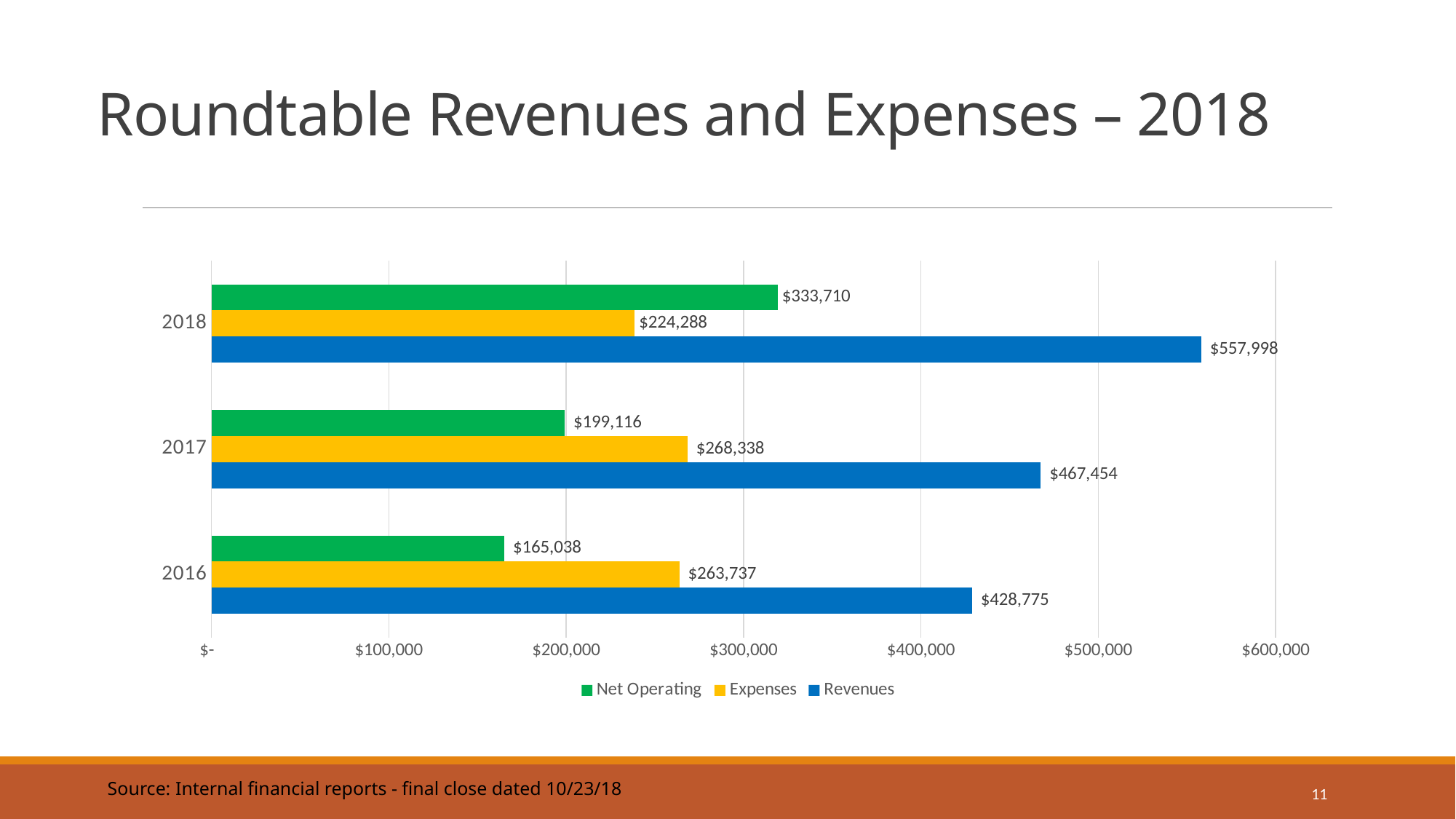
Which year had the lowest Expenses? 2018 Is the Net Operating value for 2018 greater or less than $300,000? greater What were the Revenues in 2018? $557,998 How many years are shown on the chart? 3 Which is larger: Expenses in 2016 or Expenses in 2017? Expenses in 2017 How many series does the legend list? 3 Which colour represents Revenues in the chart? Blue What kind of chart is shown on the slide? Bar chart Which year had the highest Revenues? 2018 What were the Expenses in 2017? $268,338 What was the Net Operating value in 2016? $165,038 What is the difference between Revenues in 2018 and Revenues in 2017? $90,544